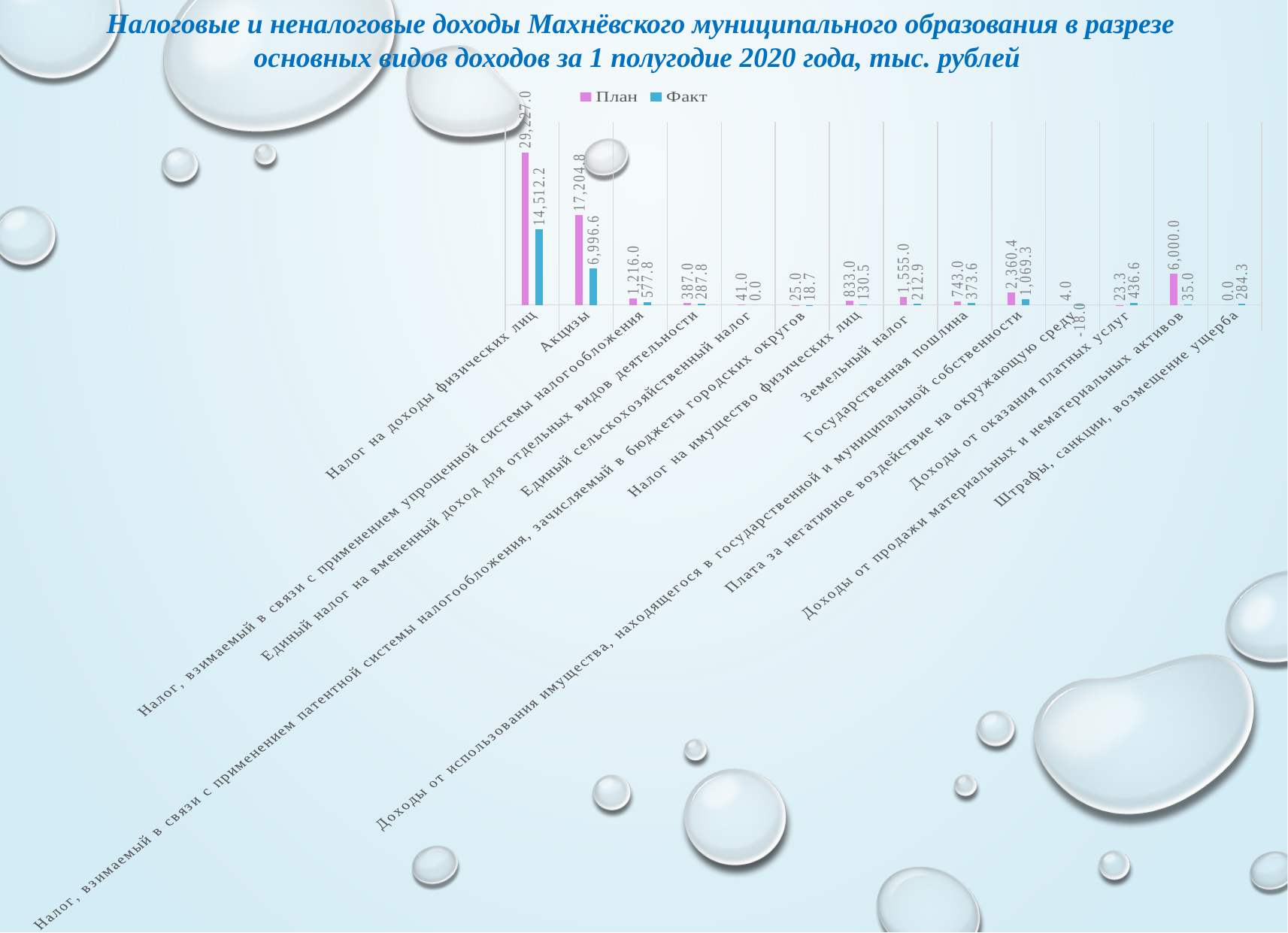
What is the План value for Акцизы? 17,204.8 Which category has the highest План value? Налог на доходы физических лиц What is the Факт value for Налог на доходы физических лиц? 14,512.2 What is the difference between the План and Факт values for Акцизы? 10,208.2 How many categories are shown on the x axis? 14 How many series does the legend list? 2 What is the Факт value for Штрафы, санкции, возмещение ущерба? 284.3 Which category has the lowest Факт value? Плата за негативное воздействие на окружающую среду What is the difference between the План and Факт values for Налог на доходы физических лиц? 14,714.8 For Доходы от оказания платных услуг, which is larger: План or Факт? Факт What is the План value for Доходы от продажи материальных и нематериальных активов? 6,000.0 What kind of chart is shown on the slide? Bar chart